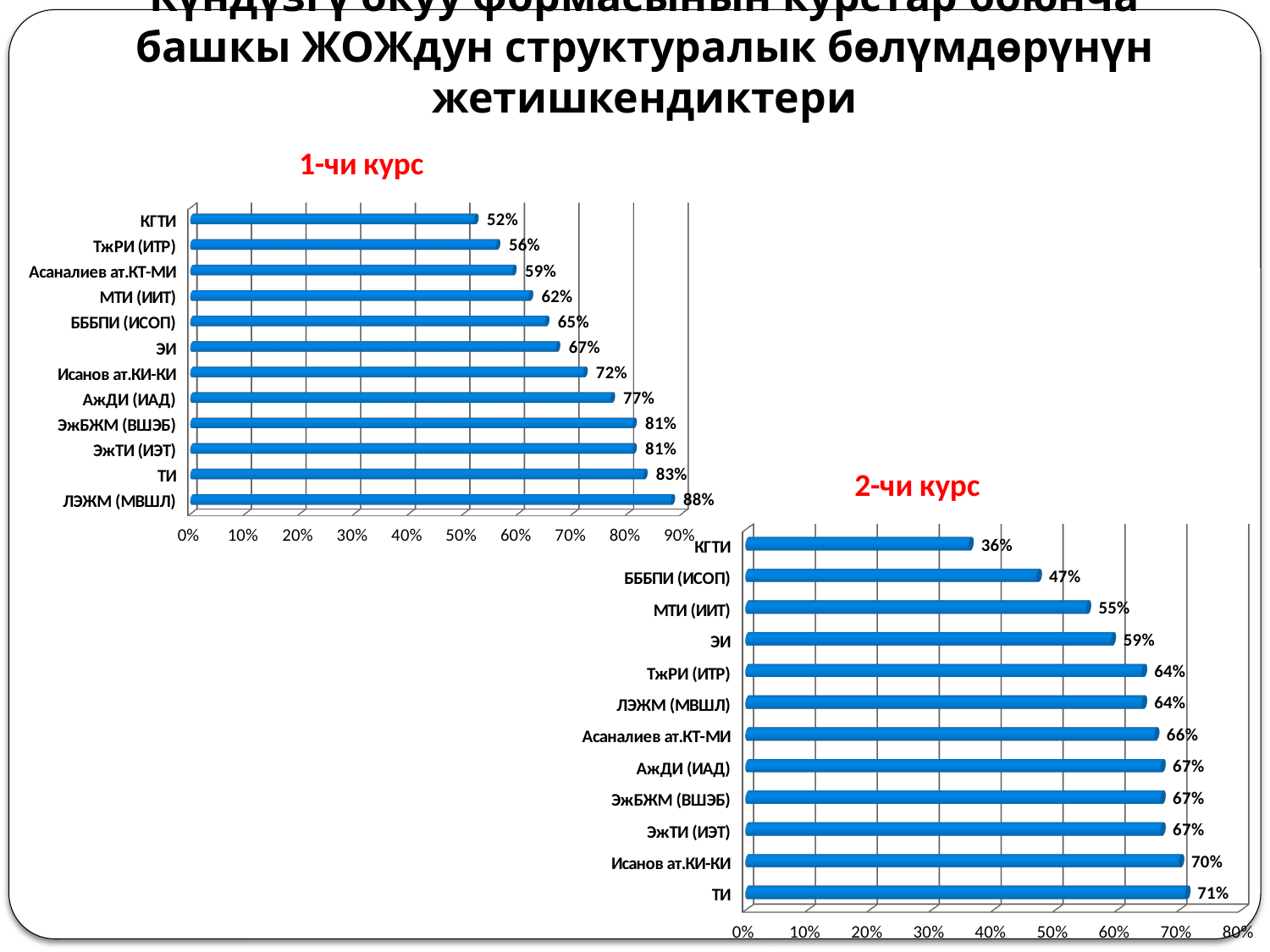
In the "1-чи курс" chart, what is the difference between the values for ТИ and КГТИ? 31% In the "1-чи курс" chart, is the value for ЭИ greater or less than 60%? greater In the "1-чи курс" chart, what is the value for ЛЭЖМ (МВШЛ)? 88% In the "2-чи курс" chart, which category has the highest value? ТИ In the "2-чи курс" chart, what is the difference between the values for ТИ and КГТИ? 35% In the "1-чи курс" chart, how many categories are shown? 12 In the "1-чи курс" chart, which category has the lowest value? КГТИ What kind of chart is the "2-чи курс" chart? Bar chart In the "2-чи курс" chart, which is larger, the value for ЭИ or the value for ТжРИ (ИТР)? ТжРИ (ИТР) In the "2-чи курс" chart, what is the value for БББПИ (ИСОП)? 47% In the "1-чи курс" chart, what is the value for МТИ (ИИТ)? 62% In the "2-чи курс" chart, what is the value for Исанов ат.КИ-КИ? 70%